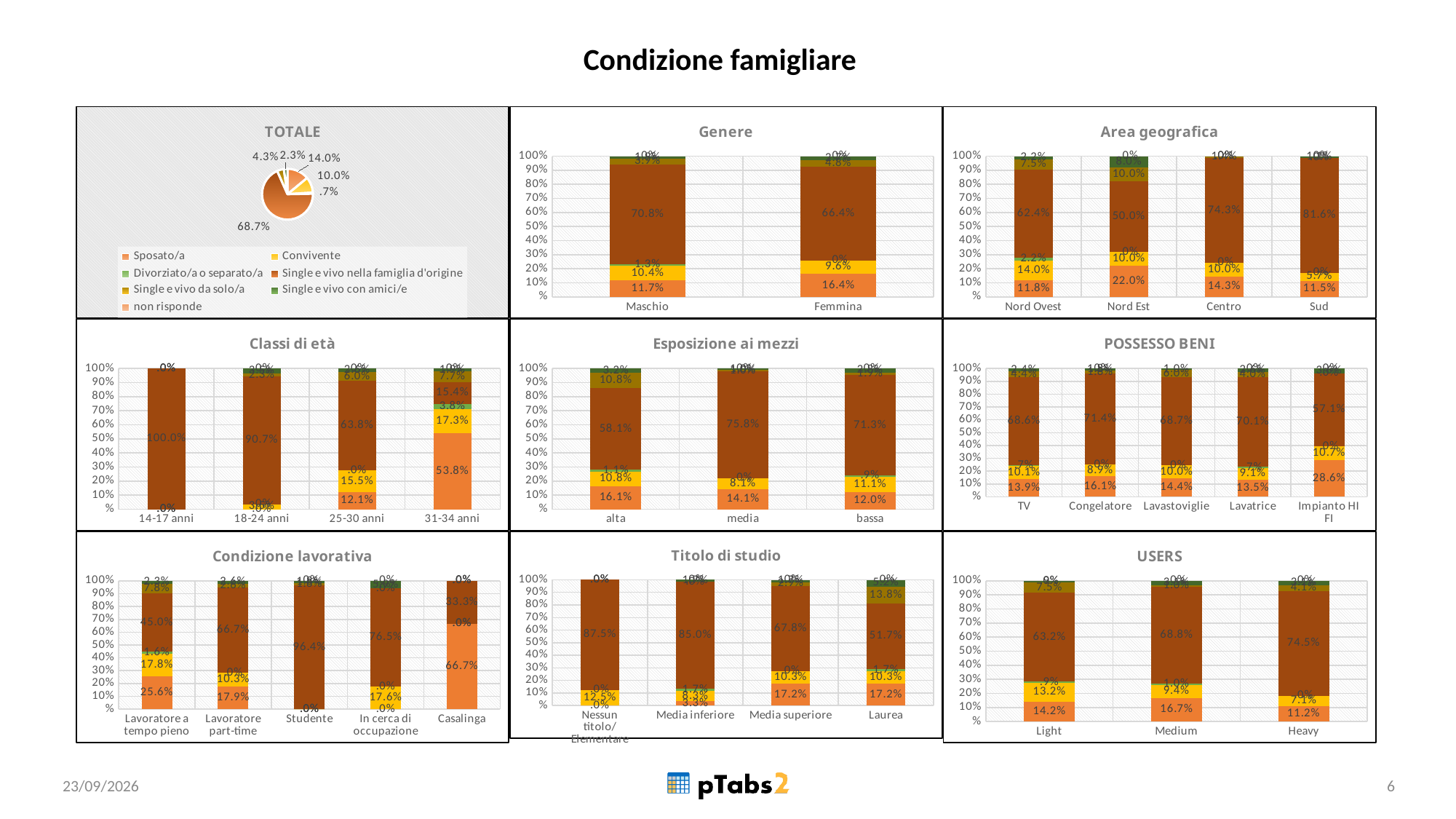
In the 'Esposizione ai mezzi' chart, what is the difference between the 'Single e vivo nella famiglia d'origine' values for media and alta? 17.7% In the 'Classi di età' chart, what is the 'Sposato/a' value for 31-34 anni? 53.8% In the 'Condizione lavorativa' chart, what is the 'Single e vivo nella famiglia d'origine' value for Studente? 96.4% In the 'Genere' chart, what is the value of the 'Single e vivo nella famiglia d'origine' segment for Maschio? 70.8% In the 'Classi di età' chart, how many age categories are shown on the x axis? 4 What type of chart is the 'TOTALE' chart? Pie chart In the 'USERS' chart, what is the 'Convivente' value for Light? 13.2% In the 'POSSESSO BENI' chart, which category has the lowest 'Single e vivo nella famiglia d'origine' value? Impianto HI FI In the 'Area geografica' chart, which category has the highest 'Single e vivo nella famiglia d'origine' value? Sud In the 'Genere' chart, what is the 'Sposato/a' value for Femmina? 16.4% In the 'Titolo di studio' chart, which is larger: the 'Single e vivo nella famiglia d'origine' value for Media inferiore or for Laurea? Media inferiore In the 'Area geografica' chart, what is the 'Sposato/a' value for Nord Est? 22.0%